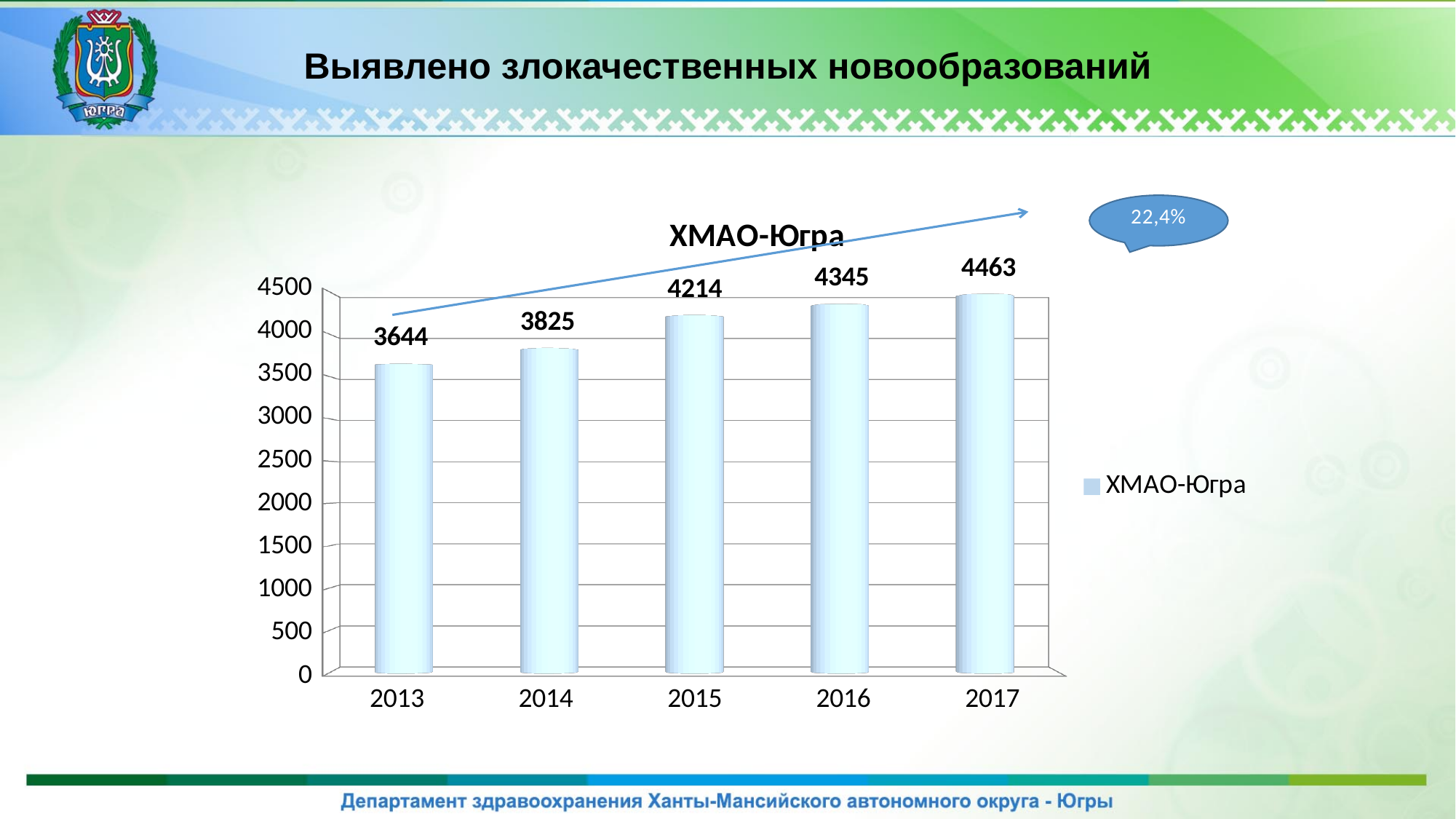
Is the value for 2014 greater or less than 4000? less What is the difference between the values for 2016 and 2015? 131 What is the value for 2015? 4214 Which year has the lowest value? 2013 Which is larger, the value for 2014 or the value for 2016? 2016 How many years are shown on the x axis? 5 Which year has the highest value? 2017 What kind of chart is shown on the slide? bar chart What is the difference between the values for 2017 and 2013? 819 Do the values rise or fall from 2013 to 2017? rise What is the value for 2017? 4463 What is the value for 2013? 3644